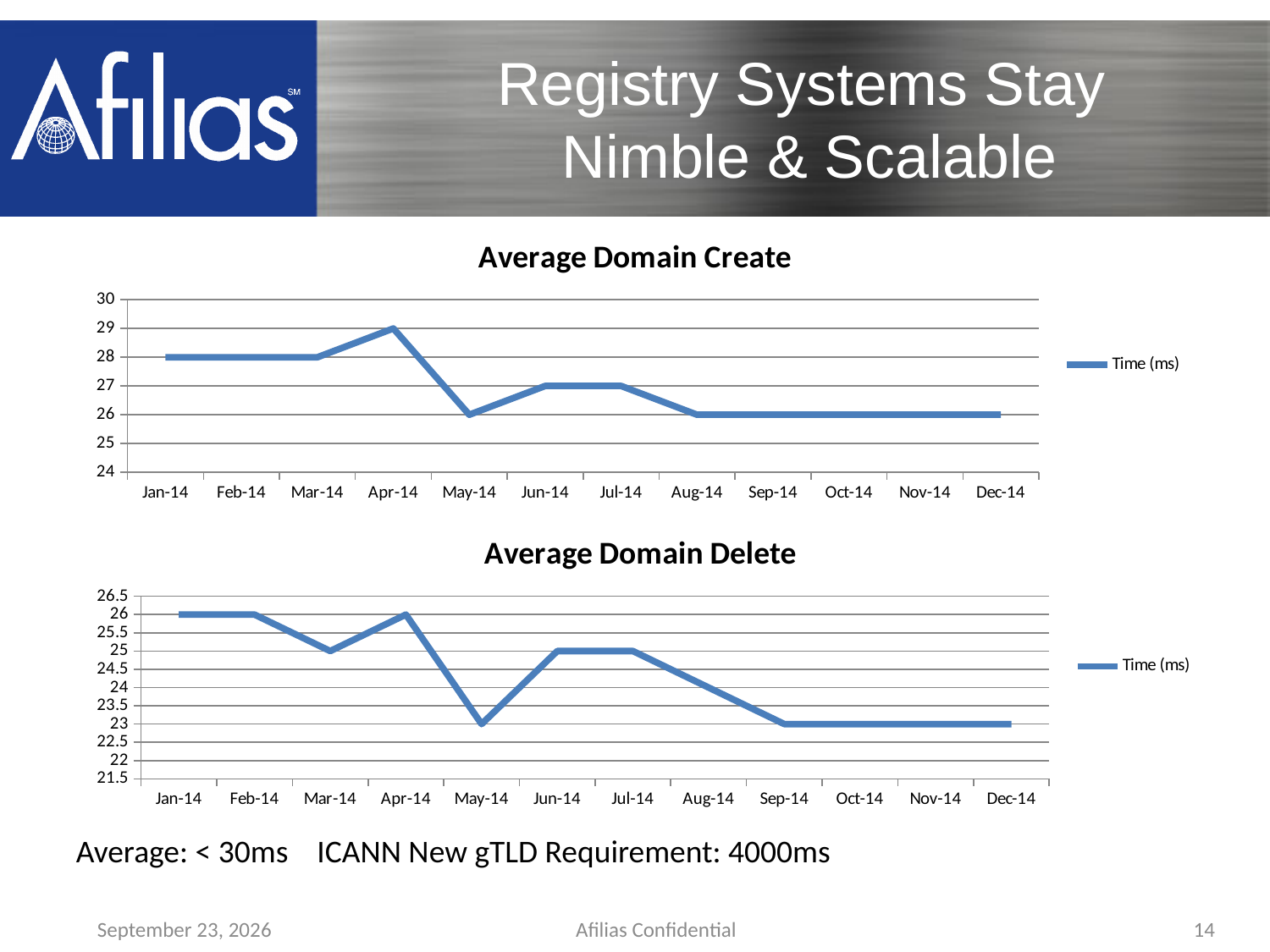
In the "Average Domain Delete" chart, which is larger, the value for Mar-14 or the value for Apr-14? Apr-14 In the "Average Domain Create" chart, what is the difference between the Apr-14 value and the May-14 value? 3 In the "Average Domain Delete" chart, what is the value for May-14? 23 In the "Average Domain Delete" chart, is the value for Sep-14 greater or less than 24? less What is the legend entry shown on the "Average Domain Delete" chart? Time (ms) What type of chart is the "Average Domain Create" chart? line chart In the "Average Domain Create" chart, what is the value for Apr-14? 29 In the "Average Domain Create" chart, do the values generally rise or fall from Jan-14 to Dec-14? fall In the "Average Domain Delete" chart, what is the difference between the Jan-14 value and the Dec-14 value? 3 How many series does the legend of the "Average Domain Create" chart list? 1 How many months are plotted on the x axis of the "Average Domain Delete" chart? 12 In the "Average Domain Create" chart, which month has the highest value? Apr-14